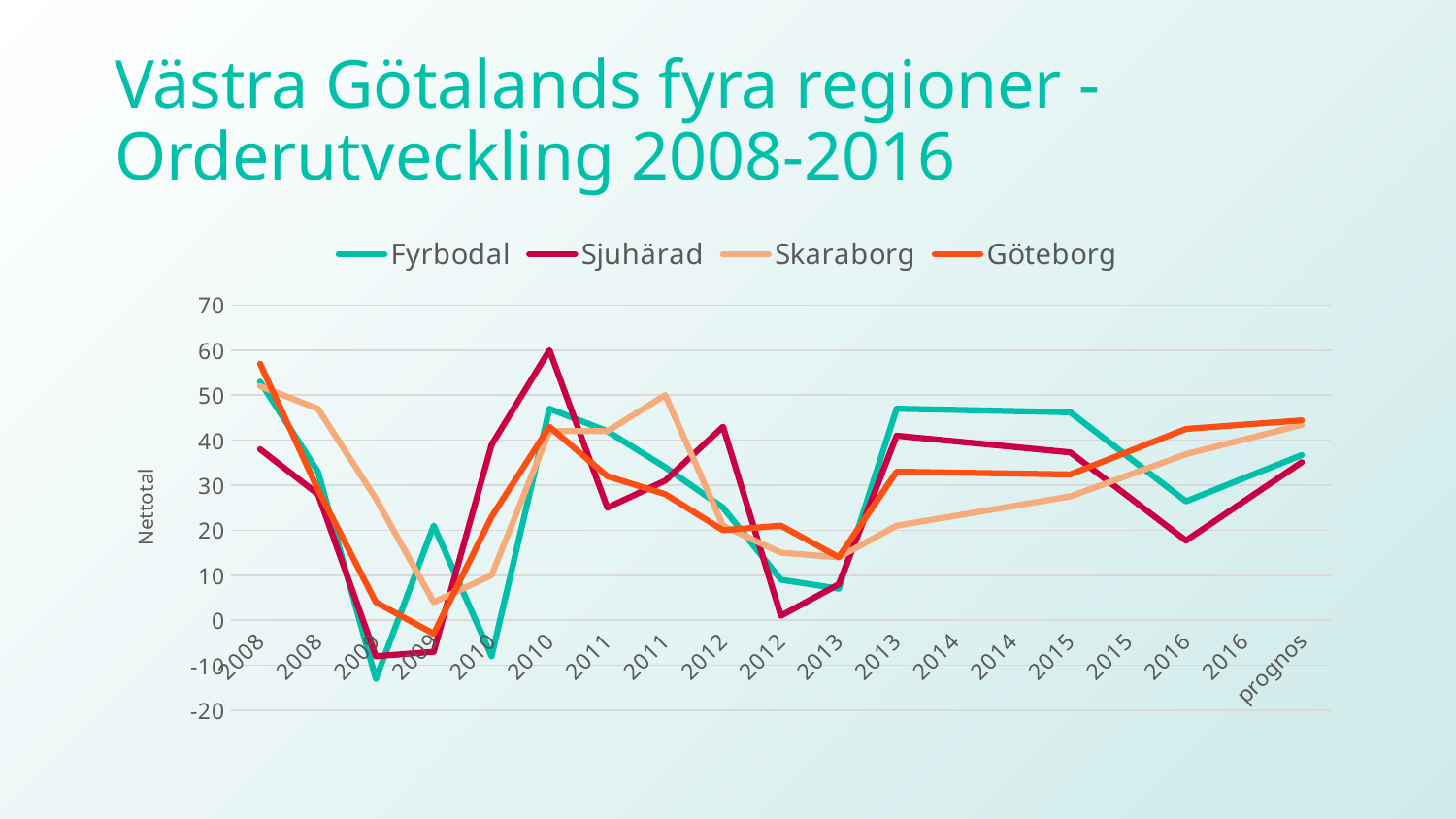
Which series is shown in the teal line? Fyrbodal How many series does the legend list? 4 Is the value for Fyrbodal at the first 2009 point greater or less than 0? less What kind of chart is shown on the slide? line chart How many points are there along the x axis? 19 Is the value for Sjuhärad at the second 2010 point greater or less than 50? greater Is the value for Skaraborg at the second 2009 point greater or less than 10? less Which series has the lowest value at the second 2016 point? Sjuhärad At the second 2013 point, which is higher: Fyrbodal or Göteborg? Fyrbodal Which series has the highest value at the second 2010 point? Sjuhärad What is the title of the vertical axis? Nettotal